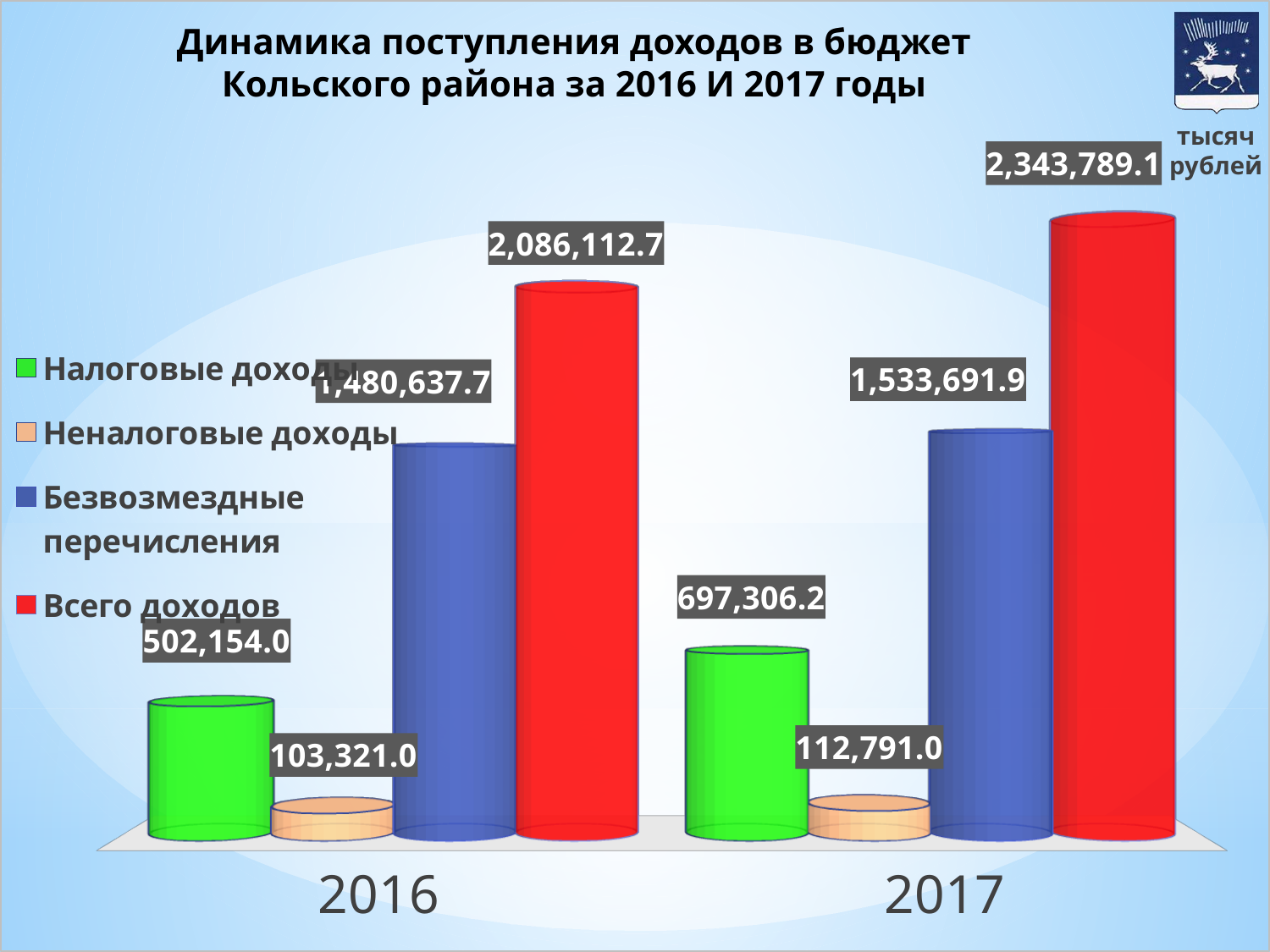
Which series has the lowest value in 2016? Неналоговые доходы What kind of chart is shown on the slide? Bar chart By how much did Всего доходов increase from 2016 to 2017? 257,676.4 What is the value of Безвозмездные перечисления for 2016? 1,480,637.7 Which series has the highest value in 2017? Всего доходов Which is larger: Безвозмездные перечисления in 2016 or in 2017? 2017 What is the value of Всего доходов for 2017? 2,343,789.1 Do the values of Налоговые доходы rise or fall from 2016 to 2017? Rise What is the value of Неналоговые доходы for 2017? 112,791.0 What is the value of Налоговые доходы for 2016? 502,154.0 What is the difference between Налоговые доходы in 2017 and in 2016? 195,152.2 How many series does the legend list? 4